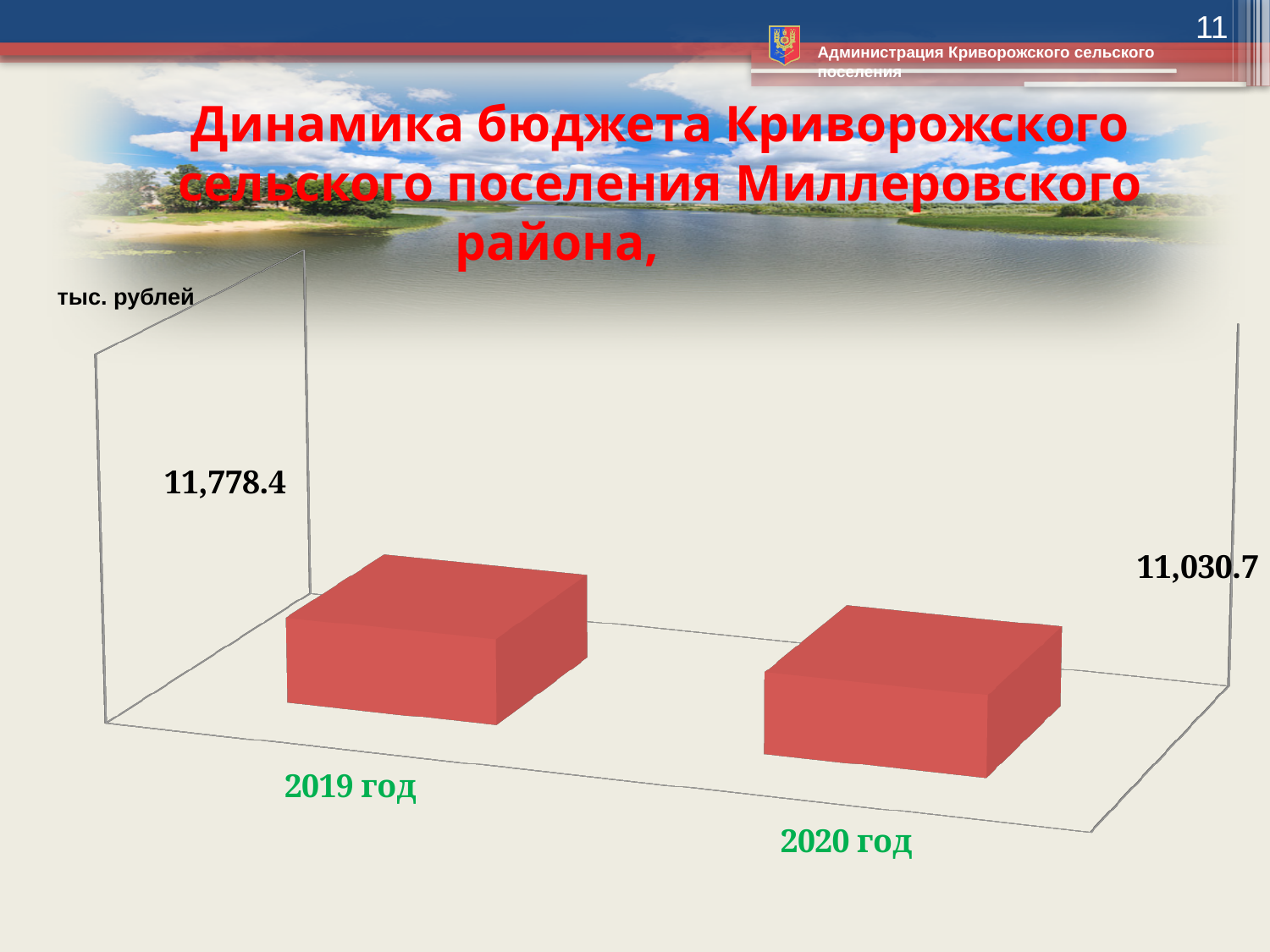
What kind of chart is shown on the slide? bar chart How many categories (years) are plotted on the chart? 2 Which year has the lower budget value? 2020 год What is the difference between the 2019 год and 2020 год values? 747.7 Is the value for 2020 год larger or smaller than the value for 2019 год? smaller What is the budget value shown for 2020 год? 11,030.7 What colour are the bars in the chart? red In what units are the chart values expressed, according to the label on the slide? тыс. рублей Do the values rise or fall from 2019 год to 2020 год? fall What is the budget value shown for 2019 год? 11,778.4 Which year has the higher budget value? 2019 год